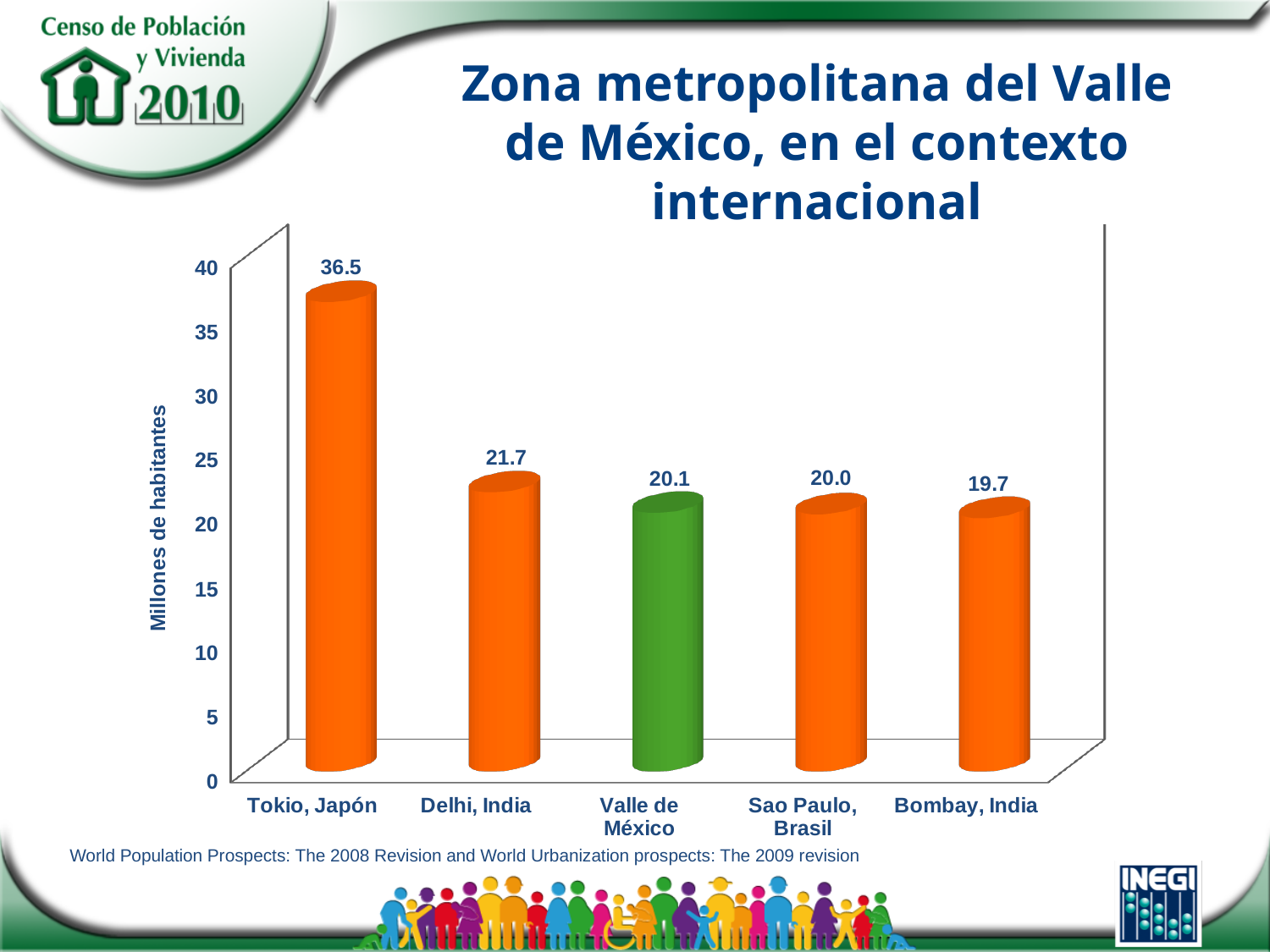
What is the value for Valle de México? 20.1 Is the value for Tokio, Japón greater or less than 35? greater What is the value for Tokio, Japón? 36.5 Which is larger, the value for Delhi, India or the value for Sao Paulo, Brasil? Delhi, India What is the difference between the values for Tokio, Japón and Delhi, India? 14.8 What is the label of the vertical axis? Millones de habitantes What is the difference between the values for Valle de México and Bombay, India? 0.4 Which category has the highest value? Tokio, Japón Which category has the lowest value? Bombay, India How many categories are shown in the chart? 5 What kind of chart is shown on the slide? bar chart What is the value for Bombay, India? 19.7